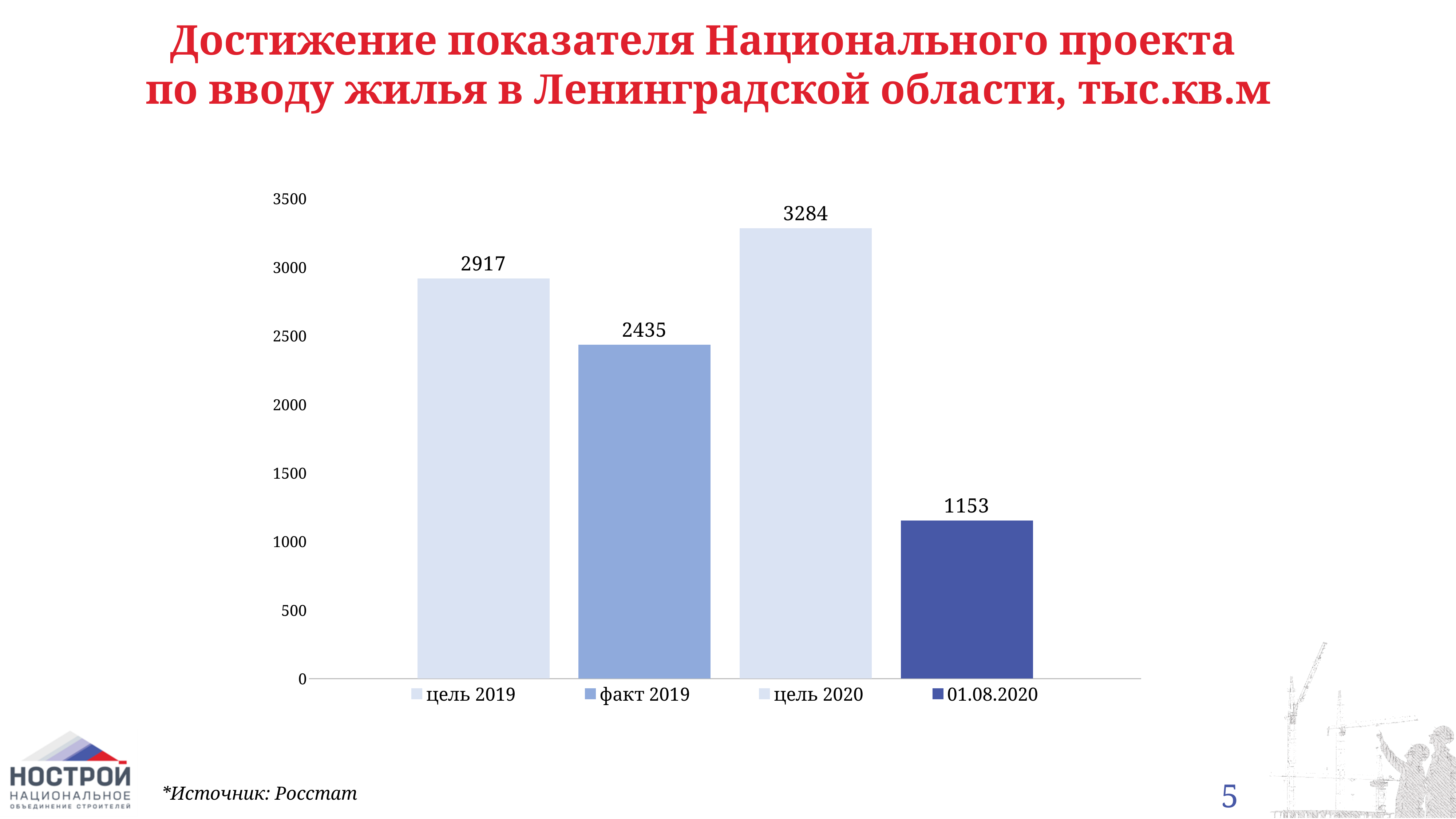
Which is larger, цель 2019 or факт 2019? цель 2019 What is the difference between цель 2019 and факт 2019? 482 What is the value for цель 2019? 2917 What kind of chart is shown on the slide? bar chart What is the value for факт 2019? 2435 How many bars are shown in the chart? 4 Which category has the lowest value? 01.08.2020 What is the value for цель 2020? 3284 What is the value for 01.08.2020? 1153 What is the difference between цель 2020 and 01.08.2020? 2131 What is the source cited at the bottom of the slide? Росстат Which category has the highest value? цель 2020